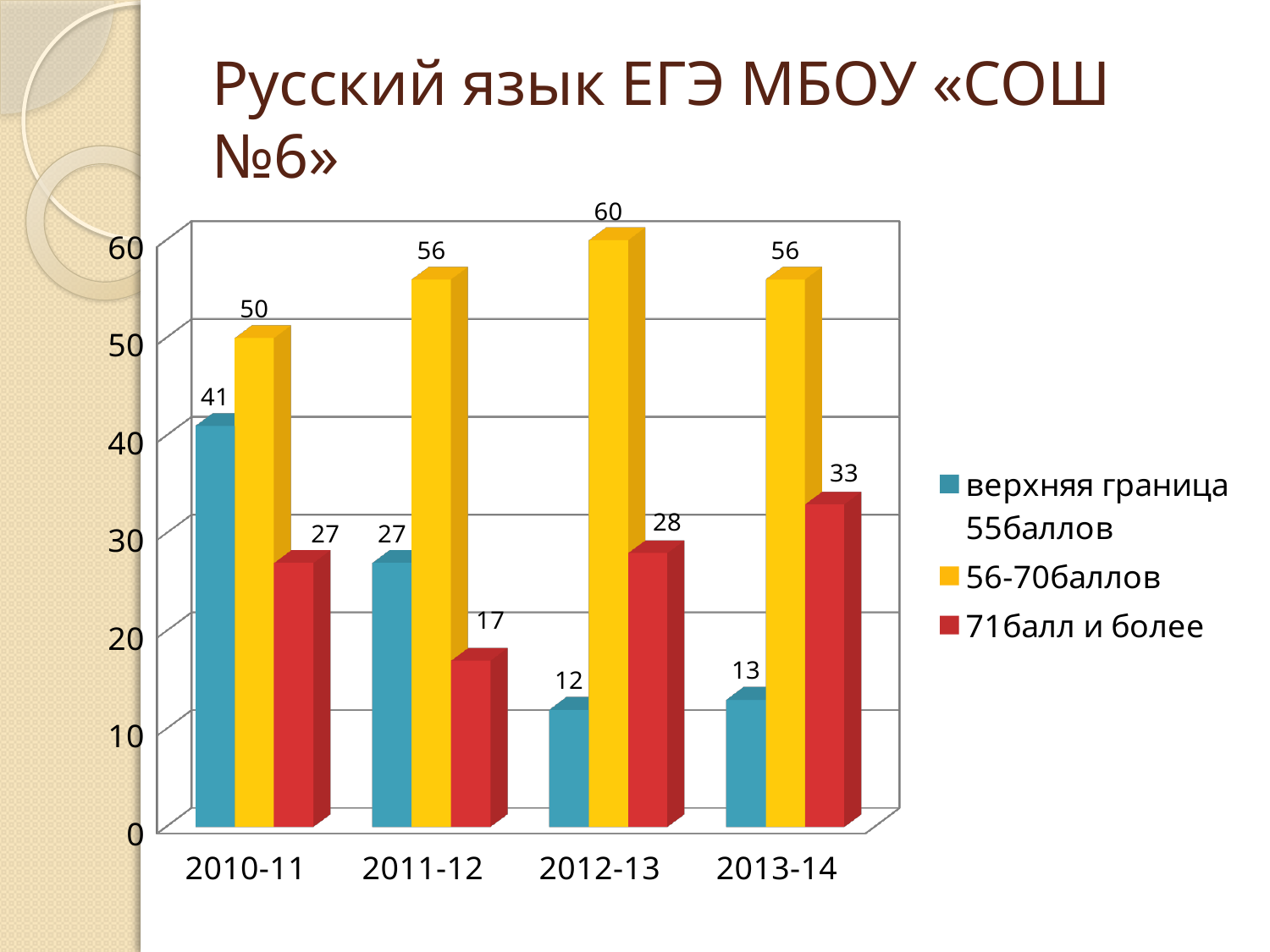
What is the value for "верхняя граница 55баллов" in 2010-11? 41 What is the value for "71балл и более" in 2013-14? 33 Which is larger in 2010-11: "верхняя граница 55баллов" or "71балл и более"? верхняя граница 55баллов What is the value for "56-70баллов" in 2012-13? 60 What kind of chart is shown on the slide? bar chart What is the difference between the "56-70баллов" value and the "71балл и более" value in 2011-12? 39 In which year is the "71балл и более" series highest? 2013-14 How many years are shown on the x axis? 4 How many series does the legend list? 3 In which year is the "верхняя граница 55баллов" series lowest? 2012-13 What colour are the bars for the "56-70баллов" series? yellow Does the "верхняя граница 55баллов" series generally rise or fall from 2010-11 to 2012-13? fall